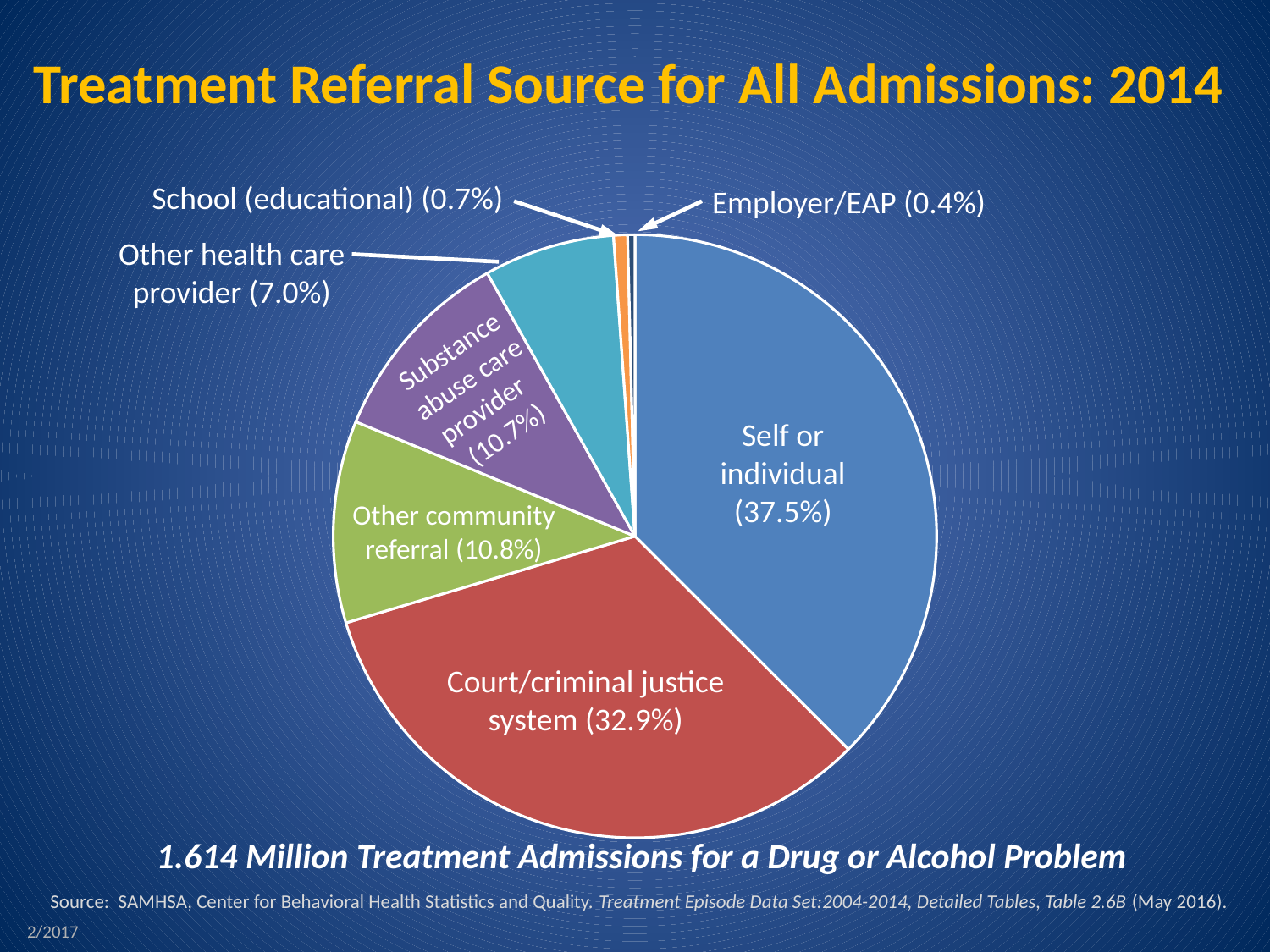
How many referral source categories are shown in the pie chart? 7 What share of admissions came from Other health care provider? 7.0% What share of admissions came from a Substance abuse care provider? 10.7% What share of admissions came from Other community referral? 10.8% Which is larger: the share for Other health care provider or the share for School (educational)? Other health care provider What share of admissions came from Self or individual referrals? 37.5% What type of chart is shown on the slide? Pie chart What share of admissions came from the Court/criminal justice system? 32.9% What share of admissions came from Employer/EAP? 0.4% What is the difference in percentage points between Self or individual and Court/criminal justice system? 4.6 Which referral source accounts for the smallest share of admissions? Employer/EAP Which referral source accounts for the largest share of admissions? Self or individual